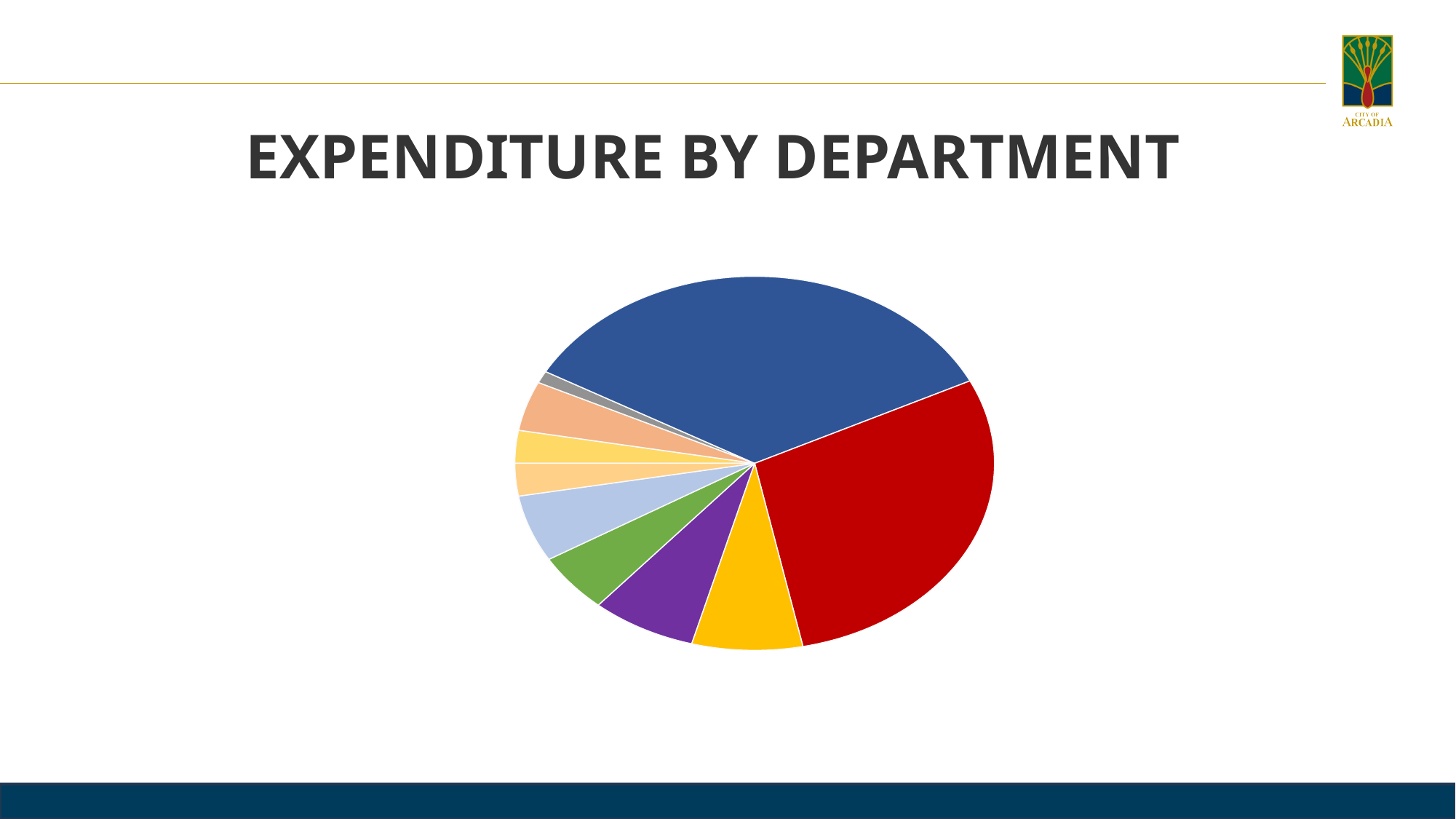
What kind of chart is shown on the slide? pie chart Which slice is larger, the dark blue slice or the red slice? dark blue Which slice is larger, the purple slice or the green slice? purple Which slice is larger, the red slice or the yellow slice? red Does the pie chart display a legend? No How many slices does the pie chart have? 10 Which colour slice is the largest in the pie chart? dark blue What is the title of the chart on the slide? EXPENDITURE BY DEPARTMENT Which colour slice is the smallest in the pie chart? gray